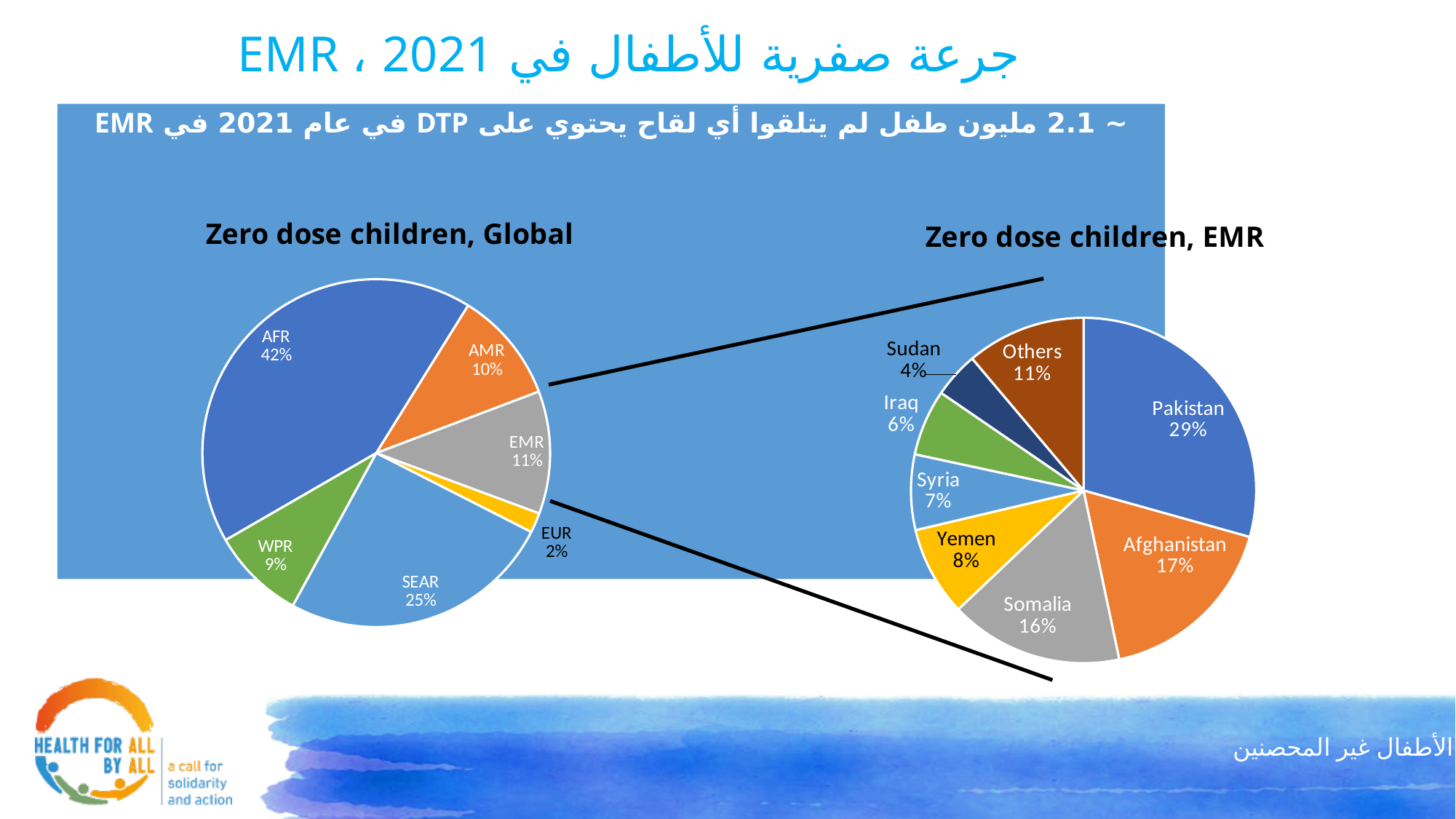
In the 'Zero dose children, EMR' chart, what share does Afghanistan have? 17% In the 'Zero dose children, Global' chart, how many regions are shown? 6 In the 'Zero dose children, Global' chart, what is the difference between the SEAR and WPR shares? 16% In the 'Zero dose children, Global' chart, what share does AFR have? 42% In the 'Zero dose children, EMR' chart, what is the difference between the Pakistan and Afghanistan shares? 12% In the 'Zero dose children, Global' chart, which region has the smallest share? EUR What type of chart is 'Zero dose children, EMR'? Pie chart In the 'Zero dose children, EMR' chart, which is larger, the share for Somalia or the share for Yemen? Somalia In the 'Zero dose children, EMR' chart, how many slices are shown? 8 In the 'Zero dose children, Global' chart, which region has the largest share? AFR In the 'Zero dose children, EMR' chart, which slice has the smallest share? Sudan In the 'Zero dose children, EMR' chart, which country has the largest share? Pakistan